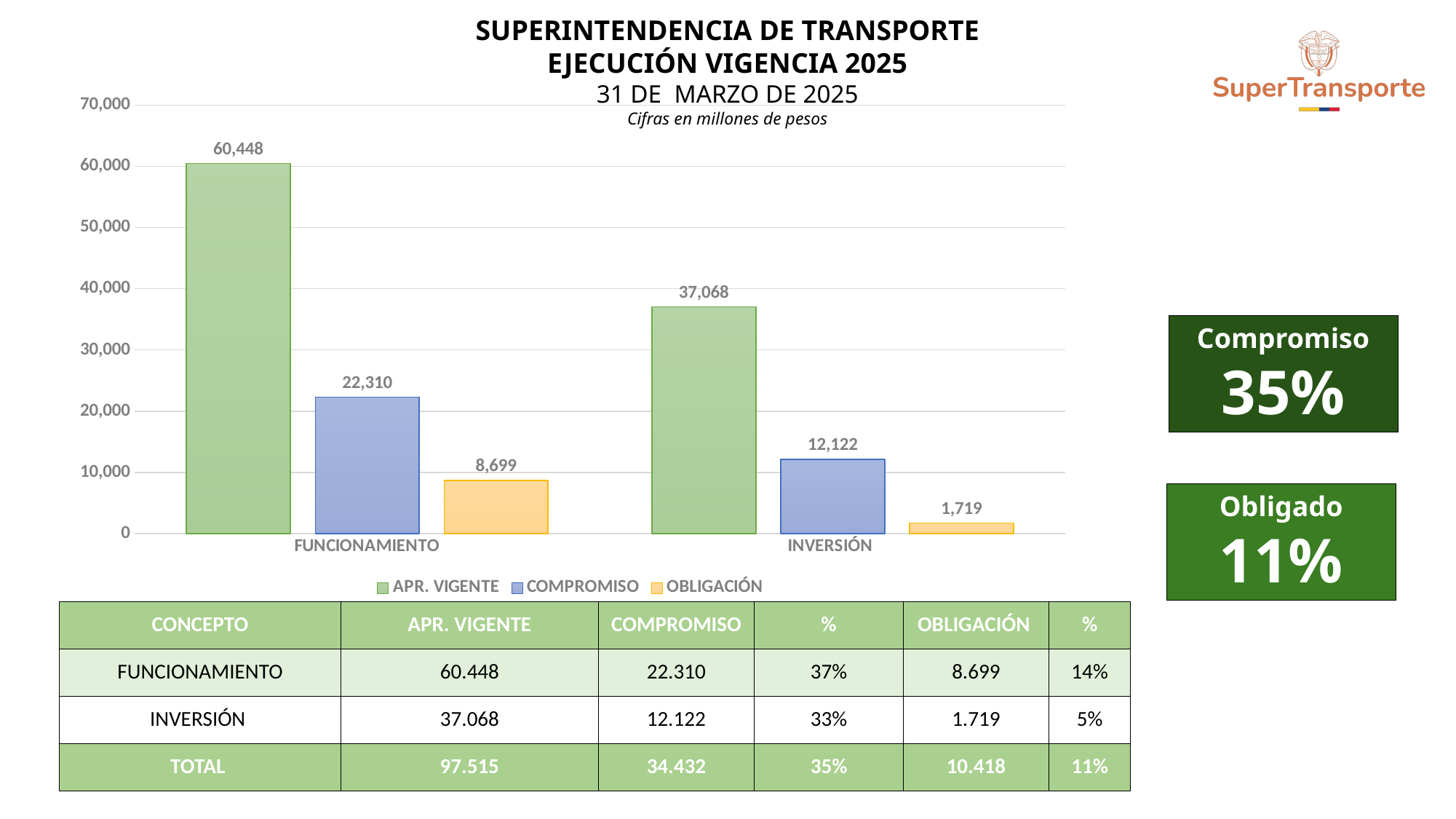
What is the APR. VIGENTE value for FUNCIONAMIENTO? 60,448 Which bar has the lowest value on the chart? OBLIGACIÓN for INVERSIÓN What is the difference between COMPROMISO and OBLIGACIÓN for INVERSIÓN? 10,403 How many series does the legend list? 3 Is the COMPROMISO value for FUNCIONAMIENTO greater or less than 20,000? greater Which is larger: COMPROMISO for FUNCIONAMIENTO or APR. VIGENTE for INVERSIÓN? APR. VIGENTE for INVERSIÓN Which category has the highest APR. VIGENTE value? FUNCIONAMIENTO What is the difference between the APR. VIGENTE values for FUNCIONAMIENTO and INVERSIÓN? 23,380 What is the COMPROMISO value for INVERSIÓN? 12,122 How many categories are shown on the x axis? 2 What kind of chart is shown on the slide? bar chart What is the OBLIGACIÓN value for FUNCIONAMIENTO? 8,699